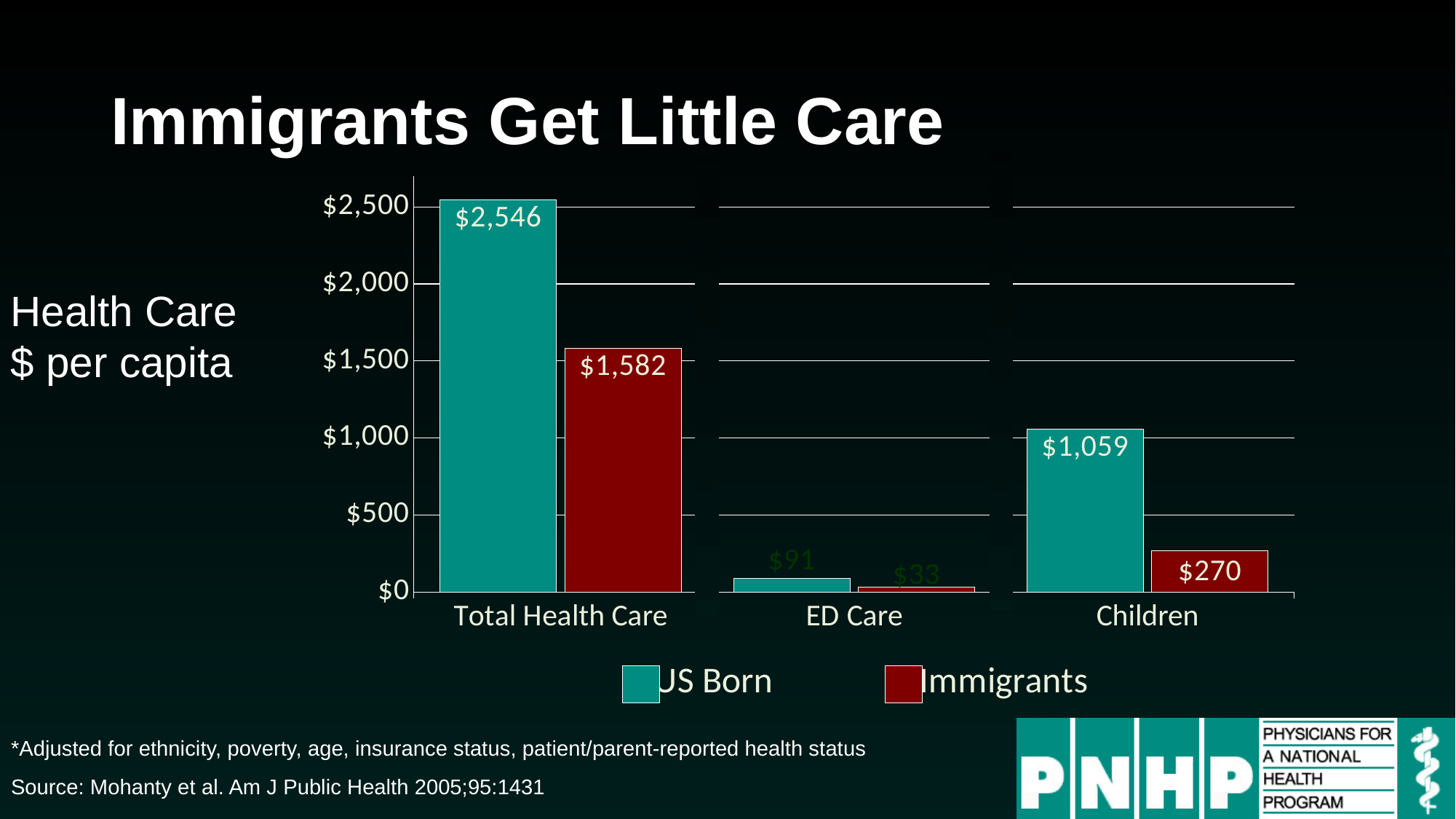
What is the difference between the US Born and Immigrants values for Total Health Care? $964 How many series does the legend list? 2 Which category has the highest US Born value? Total Health Care For Children, which is larger: the US Born value or the Immigrants value? US Born What is the Immigrants value for ED Care? $33 Which category has the lowest Immigrants value? ED Care What is the Immigrants value for Total Health Care? $1,582 What is the Immigrants value for Children? $270 What is the US Born value for ED Care? $91 What is the US Born value for Total Health Care? $2,546 What kind of chart is shown on the slide? Bar chart What is the US Born value for Children? $1,059